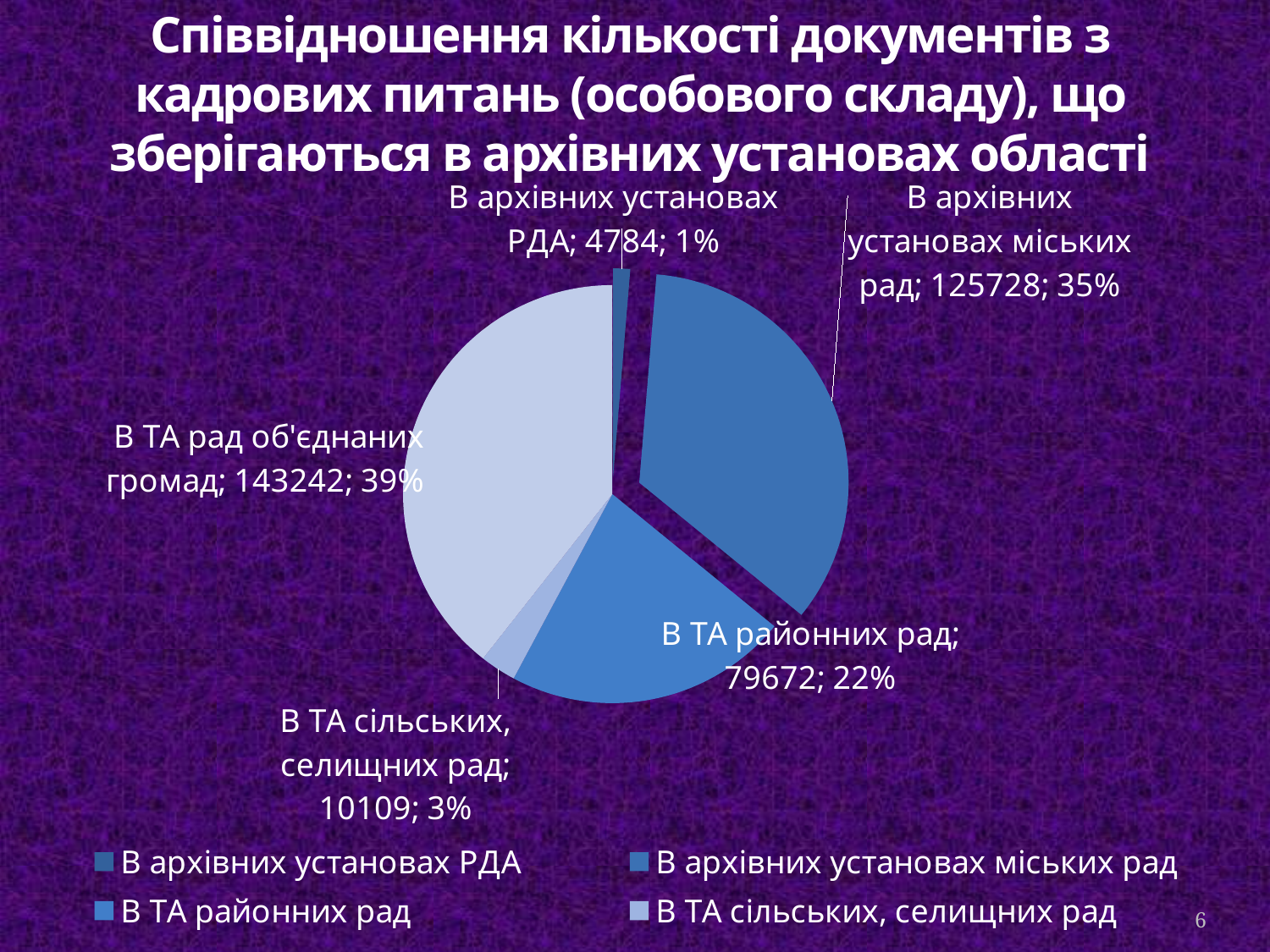
What is the value for В архівних установах РДА? 4784 What share of the pie does В ТА рад об'єднаних громад represent? 39% What kind of chart is shown on the slide? pie chart What is the value for В ТА сільських, селищних рад? 10109 What is the value for В архівних установах міських рад? 125728 What is the difference between the values for В ТА рад об'єднаних громад and В архівних установах міських рад? 17514 How many slices does the pie chart have? 5 What is the value for В ТА районних рад? 79672 Which category has the largest slice? В ТА рад об'єднаних громад Which category has the smallest slice? В архівних установах РДА What share of the pie does В ТА районних рад represent? 22% Which is larger, the value for В ТА районних рад or the value for В ТА сільських, селищних рад? В ТА районних рад